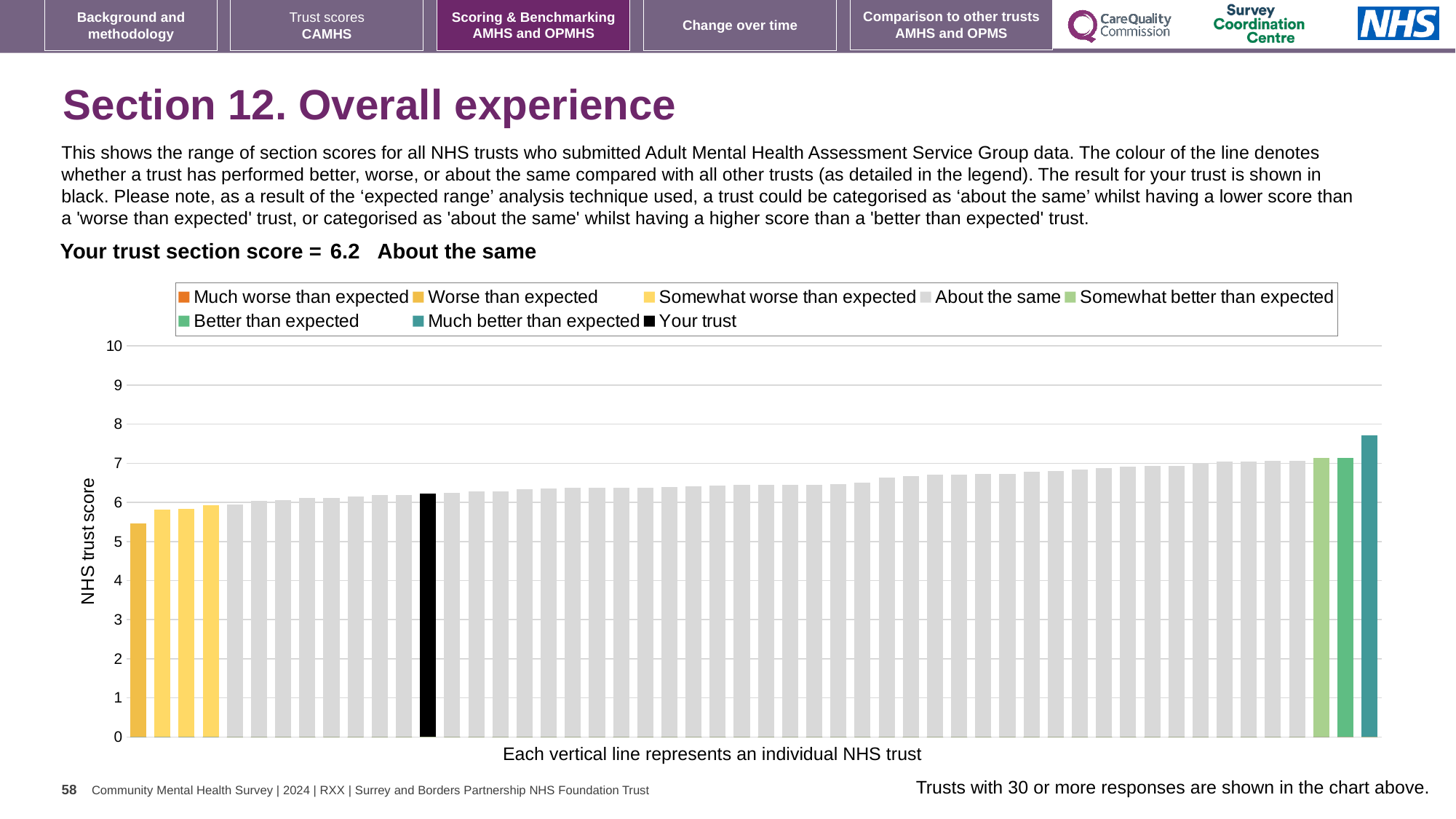
Is the value for your trust greater or less than 7? less What is the section score for your trust? 6.2 What is the label on the vertical axis? NHS trust score Is the value for your trust greater or less than 5? greater Do the bar values rise or fall from left to right along the x axis? rise How many entries does the chart legend list? 8 Is the value of the leftmost bar greater or less than 6? less Is the bar for your trust higher or lower than the leftmost bar? higher Which legend category does the tallest bar belong to? Much better than expected What kind of chart is shown on the slide? bar chart What colour is the bar for your trust? black